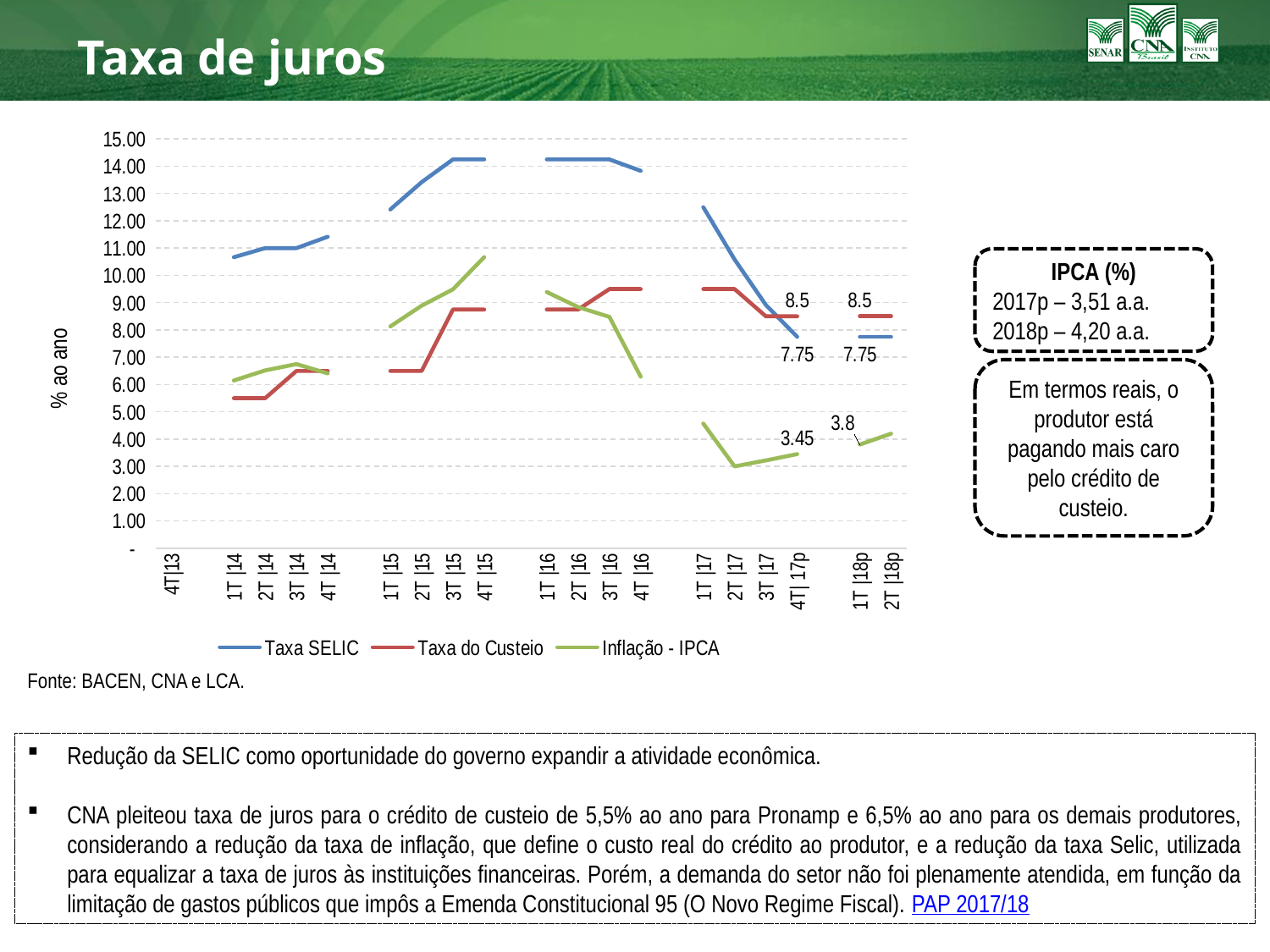
What is the value of Inflação - IPCA at 1T|18p? 3.8 Does the Taxa SELIC line rise or fall from 1T|17 to 4T|17p? fall Is the value for Inflação - IPCA at 2T|17 greater or less than 4.00? less What kind of chart is shown on the slide? line chart What is the difference between Taxa do Custeio and Taxa SELIC at 4T|17p? 0.75 How many series does the legend list? 3 What is the difference between Taxa do Custeio and Inflação - IPCA at 1T|18p? 4.7 What is the value of Inflação - IPCA at 4T|17p? 3.45 Is the value for Taxa SELIC at 3T|15 greater or less than 13.00? greater What is the value of Taxa SELIC at 1T|18p? 7.75 What is the value of Taxa do Custeio at 4T|17p? 8.5 At 1T|18p, which is larger: Taxa do Custeio or Taxa SELIC? Taxa do Custeio